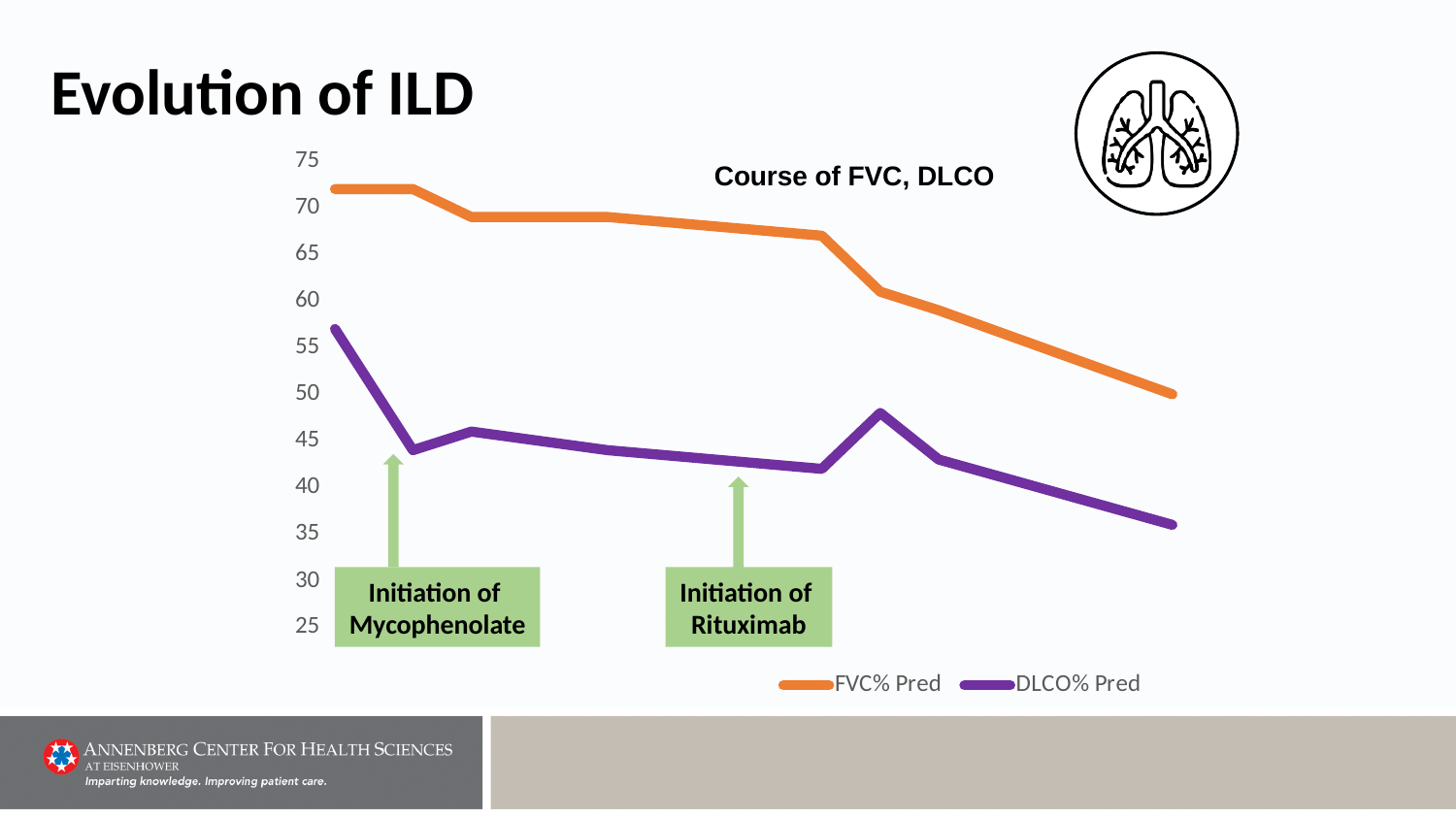
Does the DLCO% Pred line rise or fall overall from left to right? fall At which point along the x axis is the DLCO% Pred line at its highest? the first point What is the title of the chart? Course of FVC, DLCO What kind of chart is shown on the slide? line chart Which two treatment initiations are annotated on the chart? Mycophenolate and Rituximab Is the last value of the FVC% Pred line greater or less than 55? less Is the first value of the DLCO% Pred line greater or less than 50? greater Does the FVC% Pred line rise or fall overall from left to right? fall How many series does the legend list? 2 Which series has the higher values throughout the chart, FVC% Pred or DLCO% Pred? FVC% Pred Is the first value of the FVC% Pred line greater or less than 70? greater